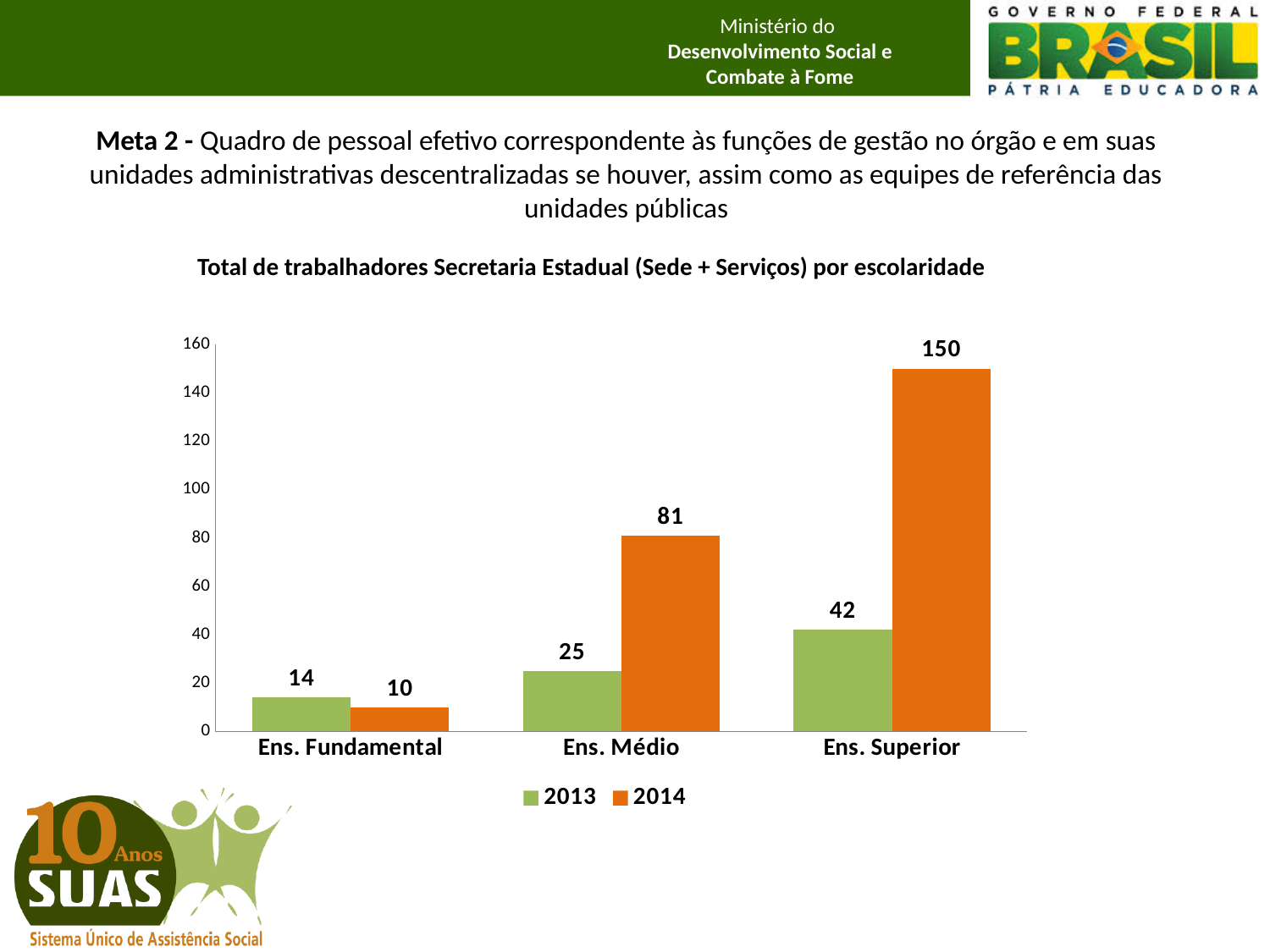
How many series does the legend list? 2 What is the value for Ens. Médio in 2014? 81 Which is larger for Ens. Médio, the 2013 value or the 2014 value? 2014 What is the difference between the 2014 and 2013 values for Ens. Superior? 108 What is the value for Ens. Fundamental in 2013? 14 What is the value for Ens. Superior in 2014? 150 Which category has the lowest value in 2013? Ens. Fundamental Which category has the highest value in 2014? Ens. Superior How many categories are shown on the x axis? 3 What kind of chart is shown on the slide? bar chart What is the difference between the 2013 and 2014 values for Ens. Fundamental? 4 Is the value for Ens. Superior in 2014 greater or less than 140? greater